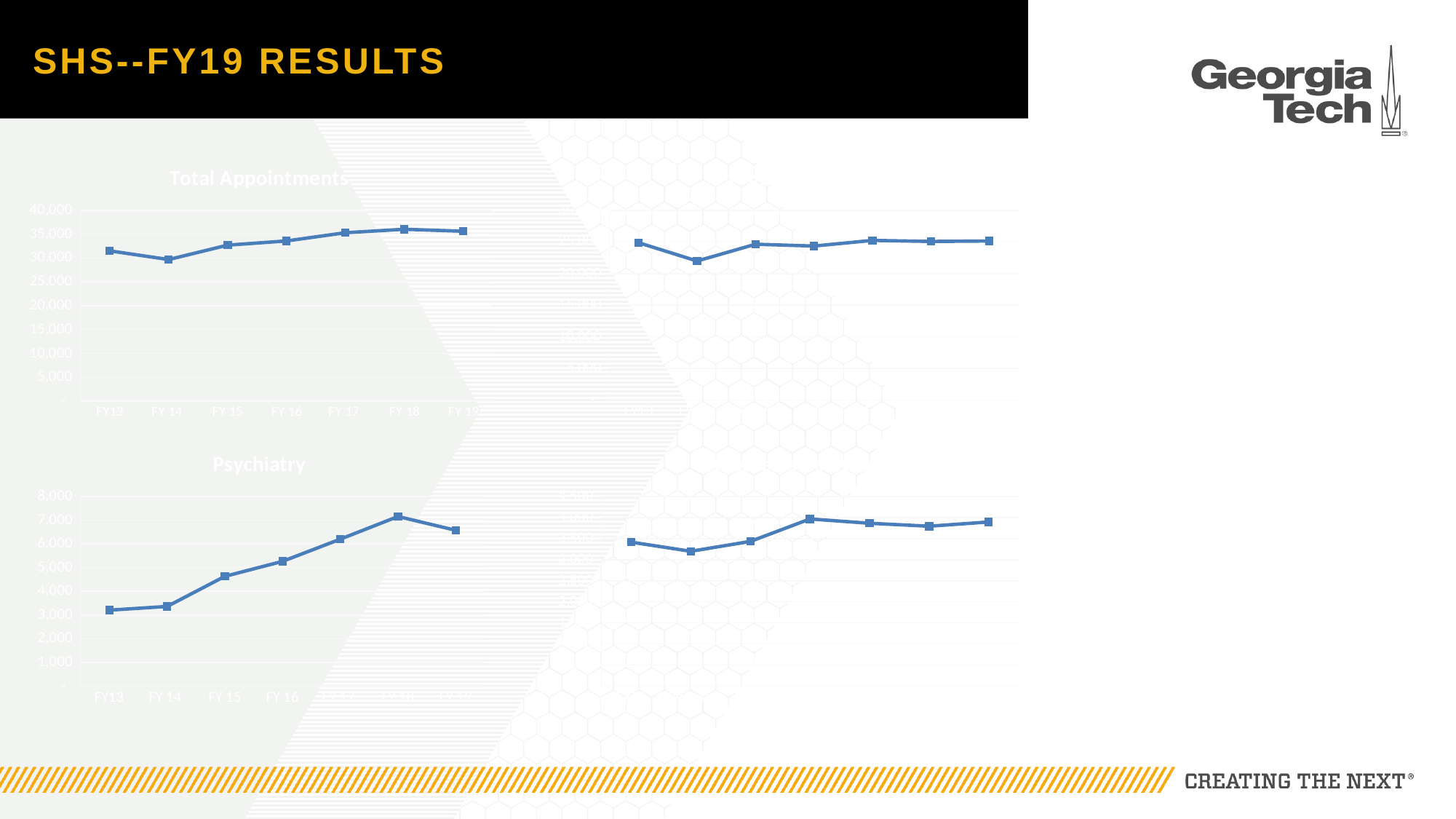
On the Psychiatry chart, do the values generally rise or fall from FY13 to FY 18? rise What kind of chart is the Psychiatry chart? line chart On the Total Appointments chart, which is larger, the value for FY 14 or the value for FY 17? FY 17 On the Psychiatry chart, is the value for FY 15 greater or less than 4,000? greater On the Total Appointments chart, is the value for FY 16 greater or less than 30,000? greater How many fiscal years are plotted on the Total Appointments chart? 7 On the Psychiatry chart, which fiscal year has the highest value? FY 18 On the Psychiatry chart, which is larger, the value for FY 18 or the value for FY 19? FY 18 On the Psychiatry chart, is the value for FY13 greater or less than 4,000? less On the Total Appointments chart, which fiscal year has the lowest value? FY 14 What kind of chart is the Total Appointments chart? line chart